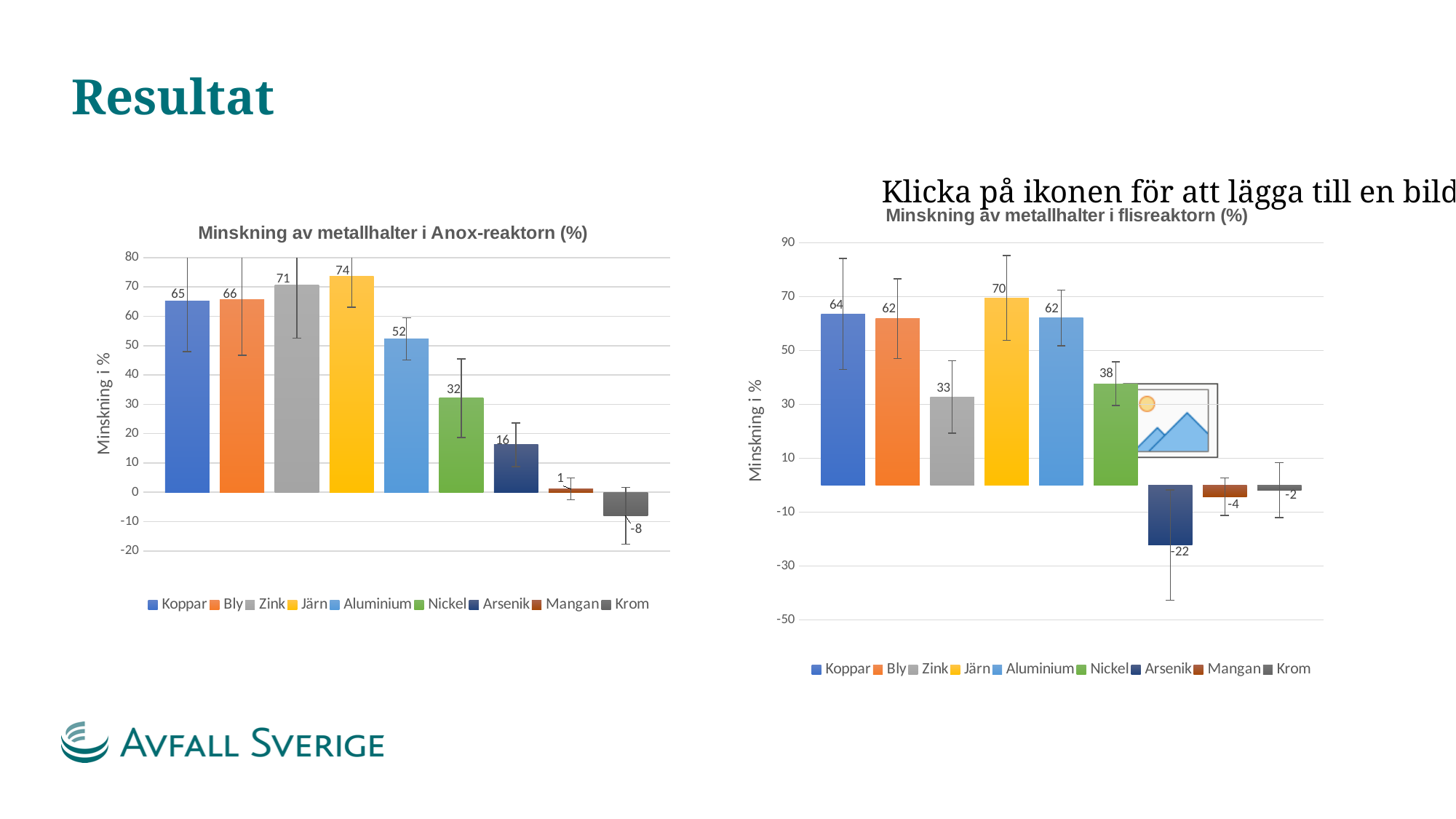
In the chart titled 'Minskning av metallhalter i flisreaktorn (%)', what is the value for Arsenik? -22 What kind of chart is the chart titled 'Minskning av metallhalter i Anox-reaktorn (%)'? Bar chart In the chart titled 'Minskning av metallhalter i Anox-reaktorn (%)', what is the difference between the values for Zink and Aluminium? 19 How many entries does the legend list in the chart titled 'Minskning av metallhalter i flisreaktorn (%)'? 9 In the chart titled 'Minskning av metallhalter i Anox-reaktorn (%)', which metal has the lowest value? Krom In the chart titled 'Minskning av metallhalter i flisreaktorn (%)', which metal has the highest value? Järn In the chart titled 'Minskning av metallhalter i Anox-reaktorn (%)', what is the value for Krom? -8 In the chart titled 'Minskning av metallhalter i flisreaktorn (%)', what is the difference between the values for Koppar and Bly? 2 In the chart titled 'Minskning av metallhalter i Anox-reaktorn (%)', which metal has the highest value? Järn What is the y-axis label of the chart titled 'Minskning av metallhalter i flisreaktorn (%)'? Minskning i % In the chart titled 'Minskning av metallhalter i Anox-reaktorn (%)', what is the value for Järn? 74 In the chart titled 'Minskning av metallhalter i flisreaktorn (%)', which is larger, the value for Zink or the value for Nickel? Nickel